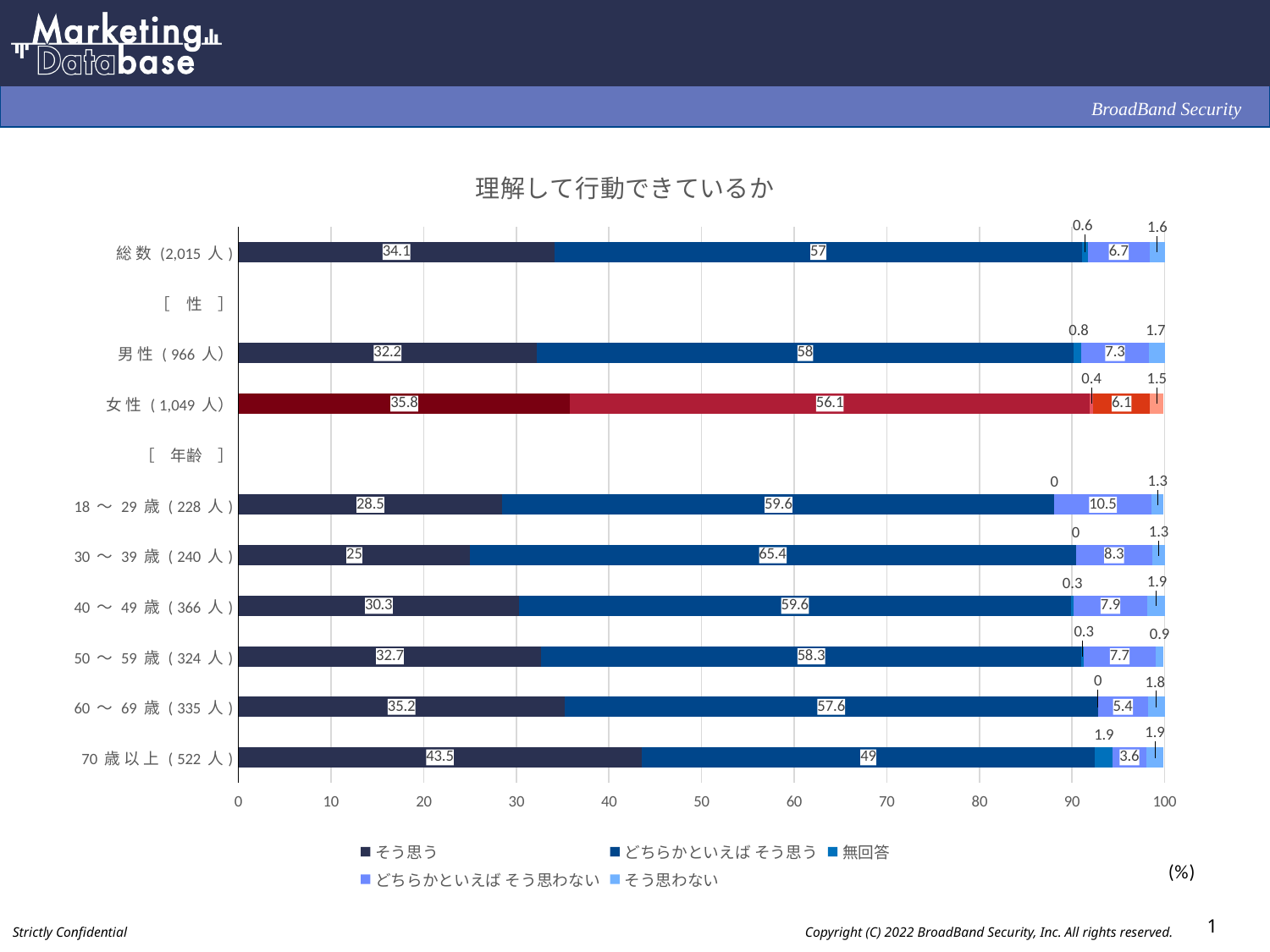
What is the total of the stacked bar for 総数 (2,015人)? 100 Which is larger, the どちらかといえば そう思う value for 男性 (966人) or for 女性 (1,049人)? 男性 (966人) What kind of chart is shown on the slide? Stacked bar chart What is the value of どちらかといえば そう思わない for 18〜29歳 (228人)? 10.5 What is the title of the chart? 理解して行動できているか What is the value of そう思う for 総数 (2,015人)? 34.1 How many categories (bars) are plotted in the chart? 9 Which category has the lowest value for そう思う? 30〜39歳 (240人) How many series does the legend list? 5 Which category has the highest value for そう思う? 70歳以上 (522人) What is the value of どちらかといえば そう思う for 30〜39歳 (240人)? 65.4 What is the difference between the そう思う values for 女性 (1,049人) and 男性 (966人)? 3.6